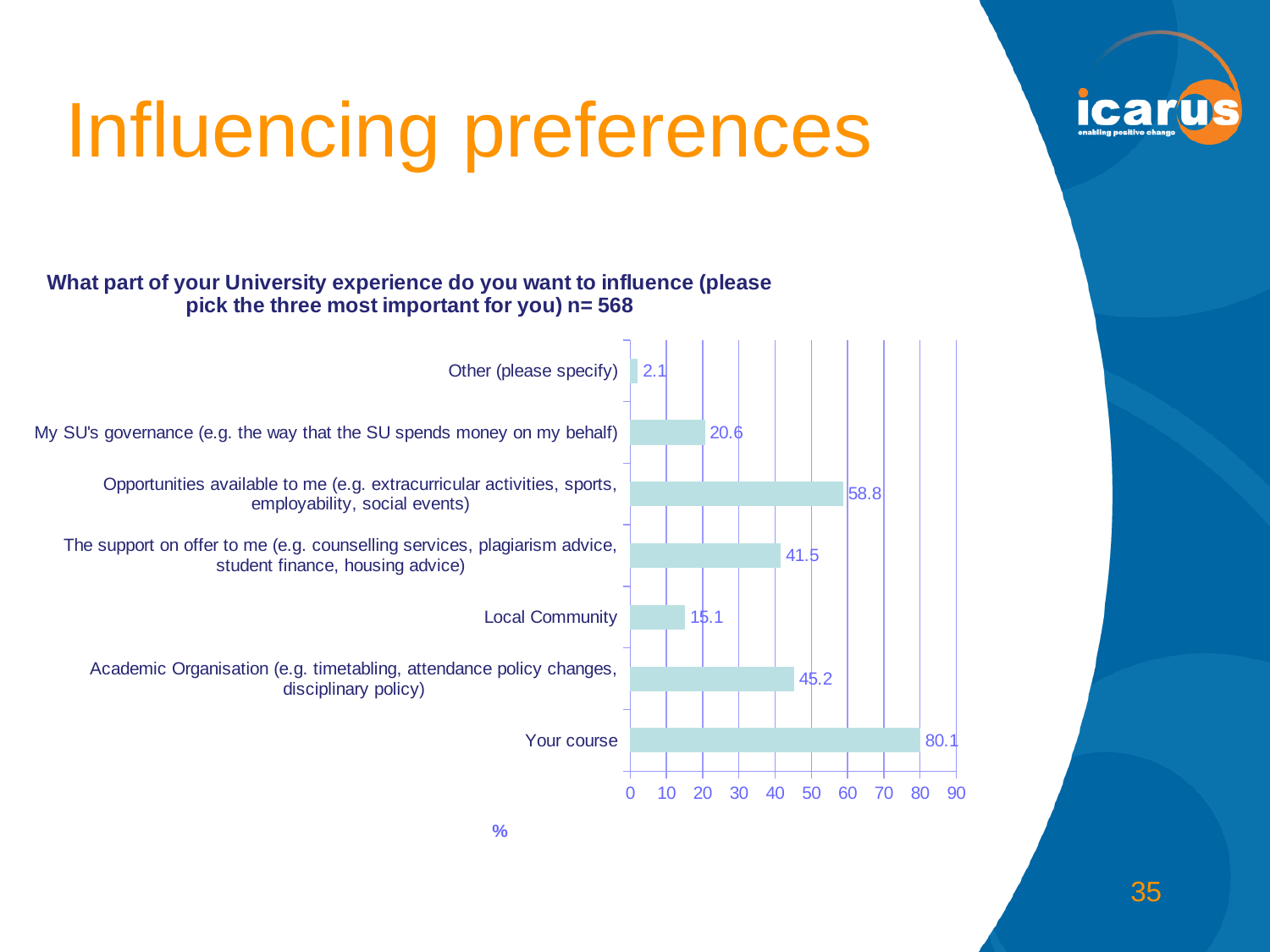
How many categories are shown in the chart? 7 What is the value for "My SU's governance (e.g. the way that the SU spends money on my behalf)"? 20.6 Which category has the highest value? Your course What kind of chart is shown on the slide? Bar chart What is the difference between the values for "Your course" and "Academic Organisation (e.g. timetabling, attendance policy changes, disciplinary policy)"? 34.9 Which is larger: the value for "Opportunities available to me" or the value for "The support on offer to me"? Opportunities available to me What is the value for "Your course"? 80.1 What is the value for "Local Community"? 15.1 What is the value for "Other (please specify)"? 2.1 What is the difference between the values for "My SU's governance" and "Local Community"? 5.5 Which category has the lowest value? Other (please specify) What is the sample size (n) stated in the chart title? 568